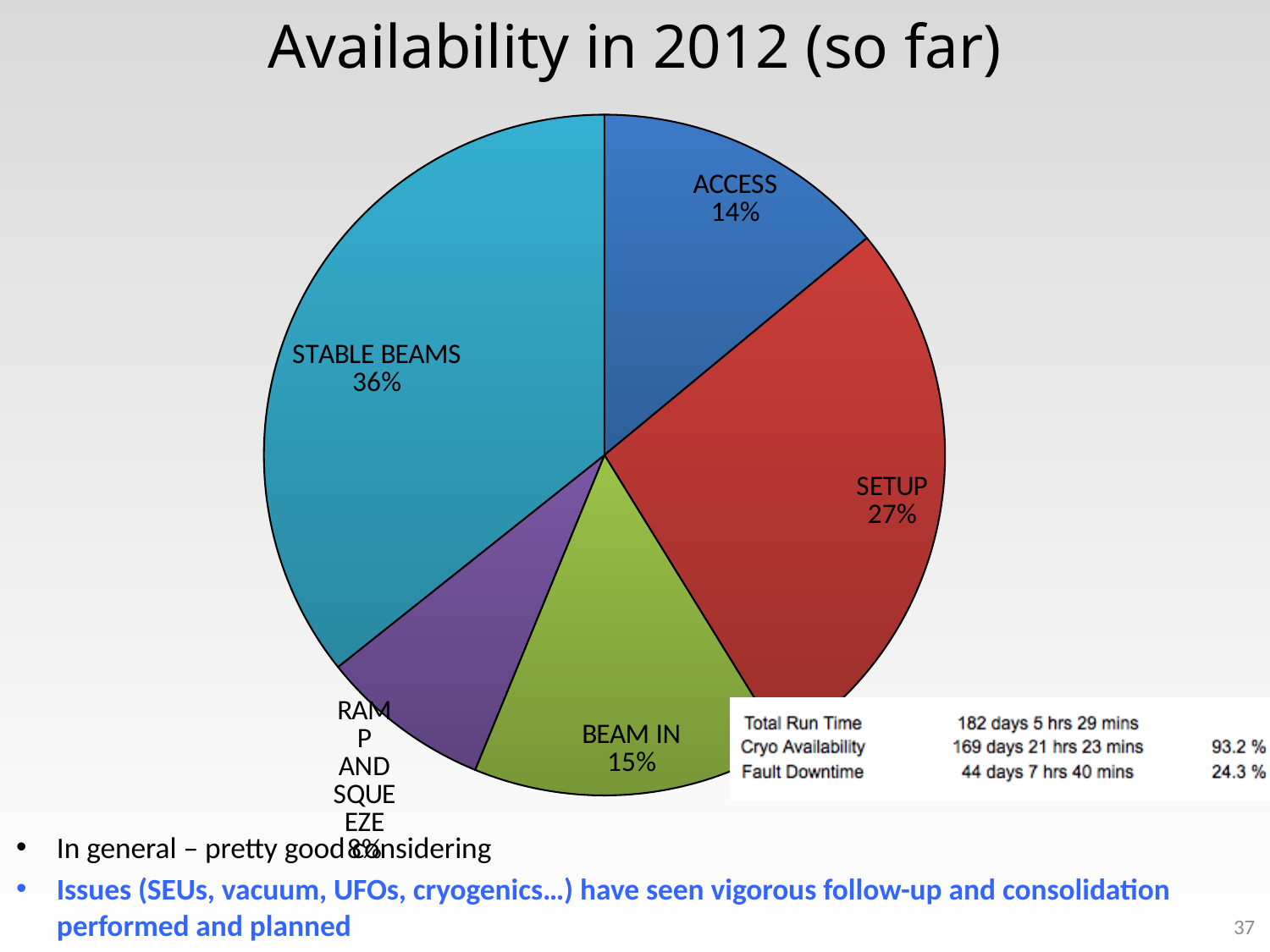
Which slice of the pie is the smallest? RAMP AND SQUEEZE Which is larger, the SETUP slice or the BEAM IN slice? SETUP What is the difference in percentage points between STABLE BEAMS and SETUP? 9 Which slice of the pie is the largest? STABLE BEAMS What share of the pie is SETUP? 27% What share of the pie is ACCESS? 14% What share of the pie is BEAM IN? 15% What kind of chart is shown on the slide? pie chart How many slices does the pie chart have? 5 What is the title of the chart? Availability in 2012 (so far)